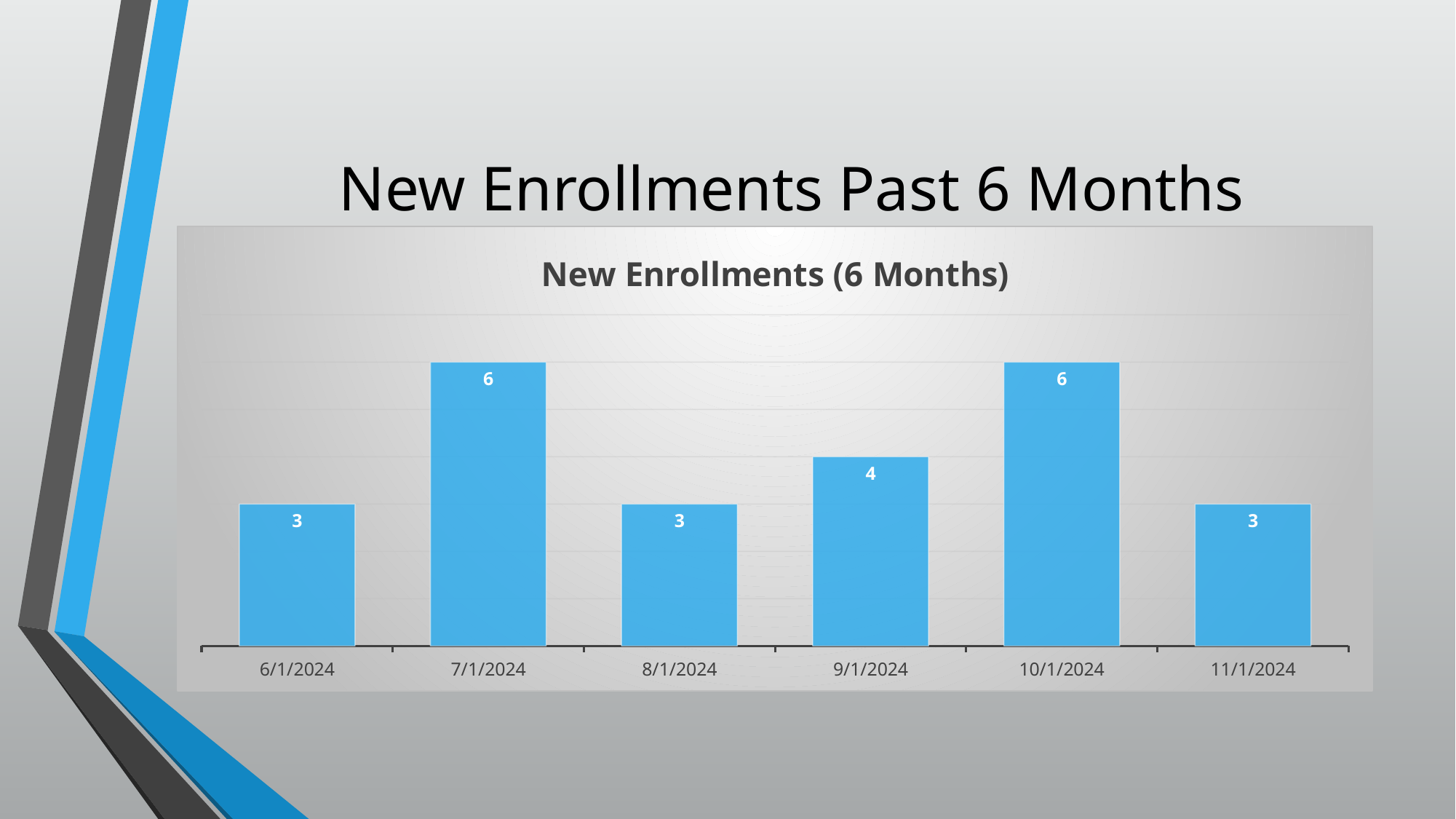
What kind of chart is shown on the slide? Bar chart What is the title of the chart? New Enrollments (6 Months) Which months have the highest value? 7/1/2024 and 10/1/2024 What is the total of all six values shown in the chart? 25 What is the value for 6/1/2024? 3 How many months are shown on the x axis? 6 What is the difference between the values for 7/1/2024 and 9/1/2024? 2 What is the value for 7/1/2024? 6 What is the value for 11/1/2024? 3 What is the lowest value shown in the chart? 3 What is the value for 9/1/2024? 4 Which is larger, the value for 9/1/2024 or the value for 8/1/2024? 9/1/2024